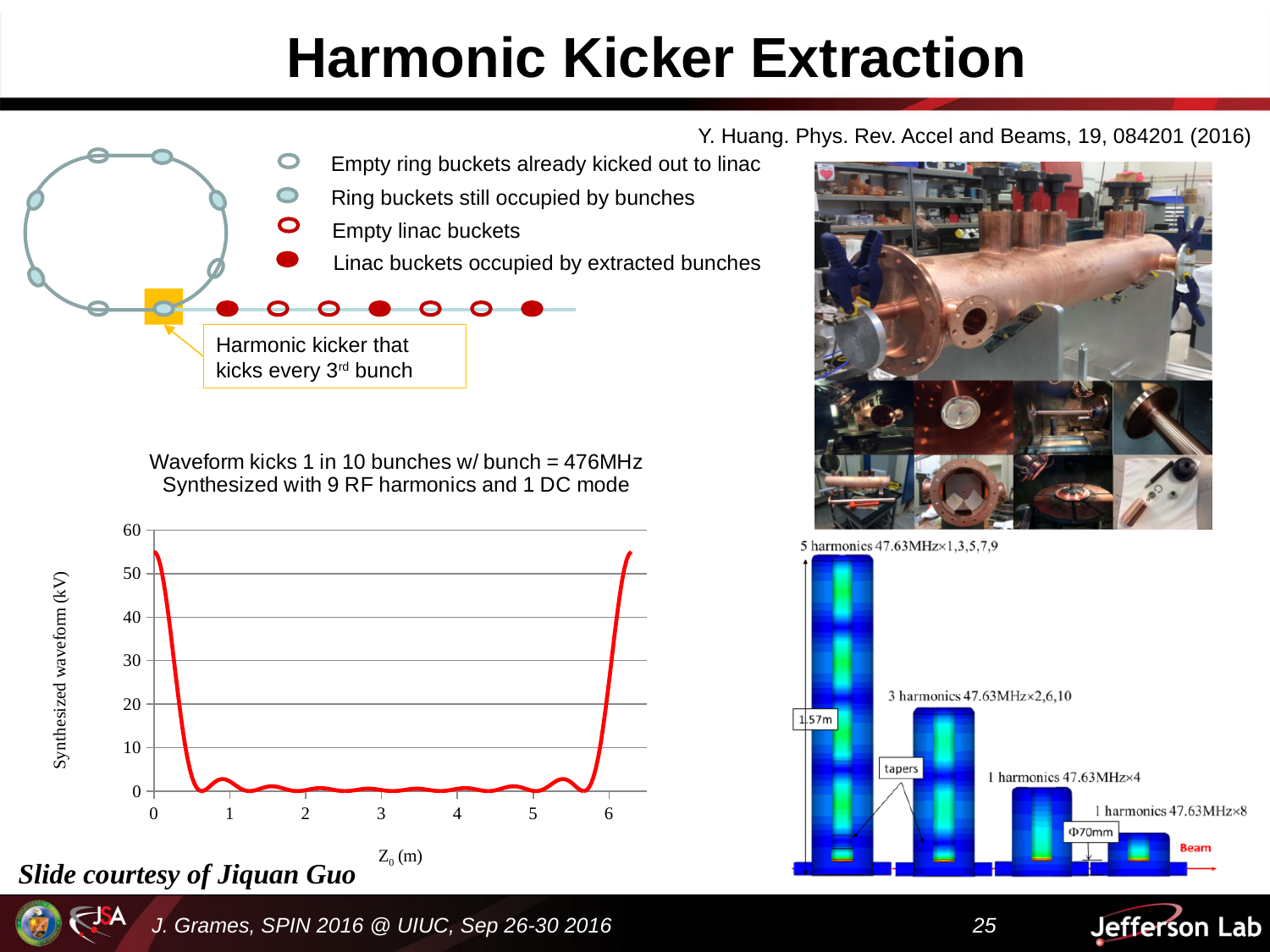
How many labelled tick marks are on the x axis of the waveform chart? 7 What kind of chart is shown at the bottom left of the slide? line chart Does the synthesized waveform rise or fall as Z0 goes from 0 to 1? fall What is the highest tick value shown on the y axis of the waveform chart? 60 What is the label of the x axis of the waveform chart? Z0 (m) Is the value of the synthesized waveform at Z0 = 3 greater or less than 10? less Does the synthesized waveform rise or fall as Z0 goes from 5.5 to 6.3? rise Which is larger, the synthesized waveform value at Z0 = 0 or at Z0 = 3? Z0 = 0 Is the value of the synthesized waveform at Z0 = 1 greater or less than 10? less What is the label of the y axis of the waveform chart? Synthesized waveform (kV) Is the value of the synthesized waveform at Z0 = 0 greater or less than 50? greater